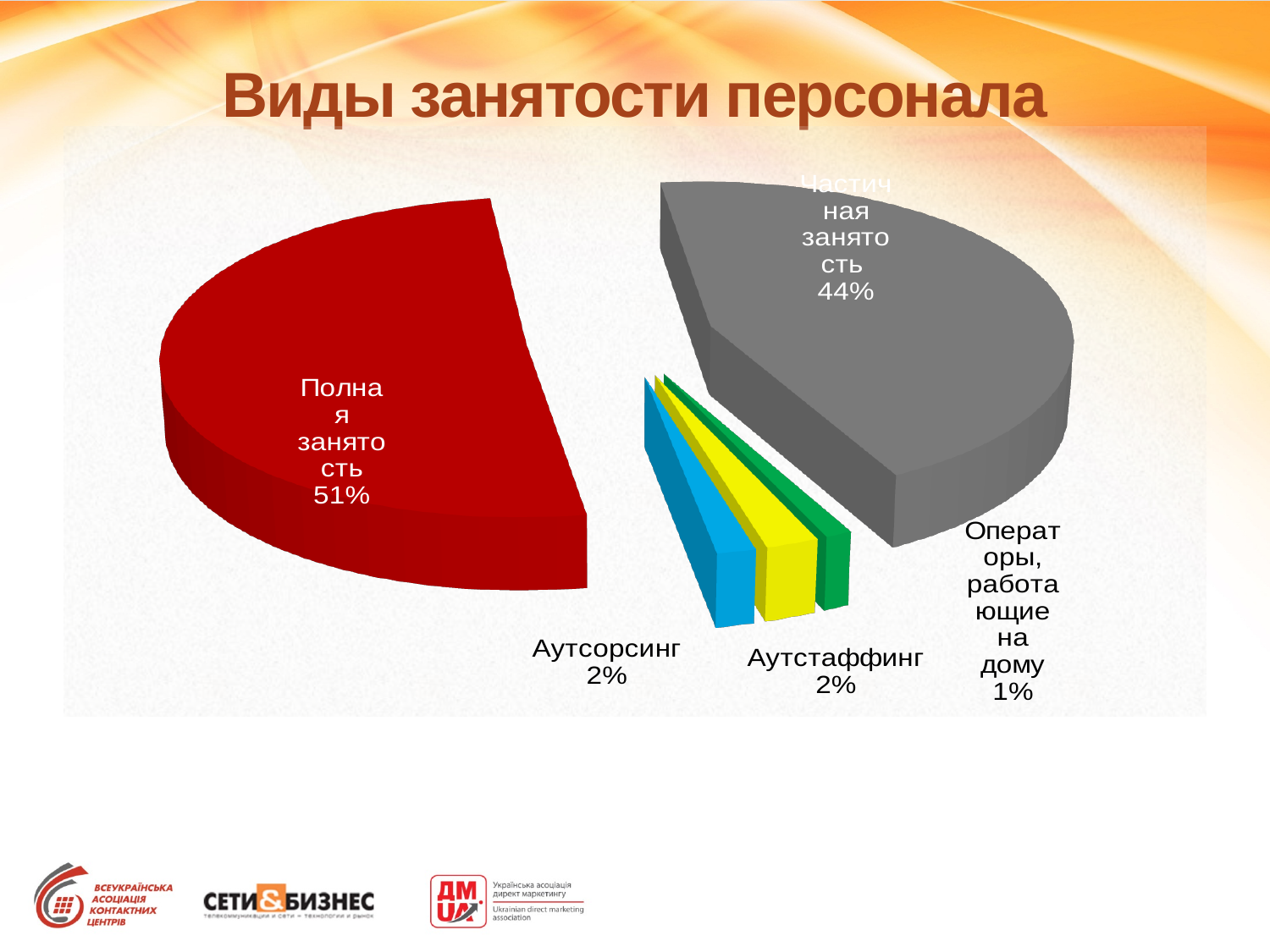
What share of the pie does "Операторы, работающие на дому" have? 1% What is the title of the chart? Виды занятости персонала What colour is the slice for "Полная занятость"? Red How many slices does the pie chart have? 5 Which is larger, the slice for "Частичная занятость" or the slice for "Аутстаффинг"? Частичная занятость What is the difference in percentage points between "Полная занятость" and "Частичная занятость"? 7 Which category has the largest slice of the pie? Полная занятость What share of the pie does "Частичная занятость" have? 44% What share of the pie does "Аутсорсинг" have? 2% What kind of chart is shown on the slide? Pie chart Which category has the smallest slice of the pie? Операторы, работающие на дому What share of the pie does "Полная занятость" have? 51%